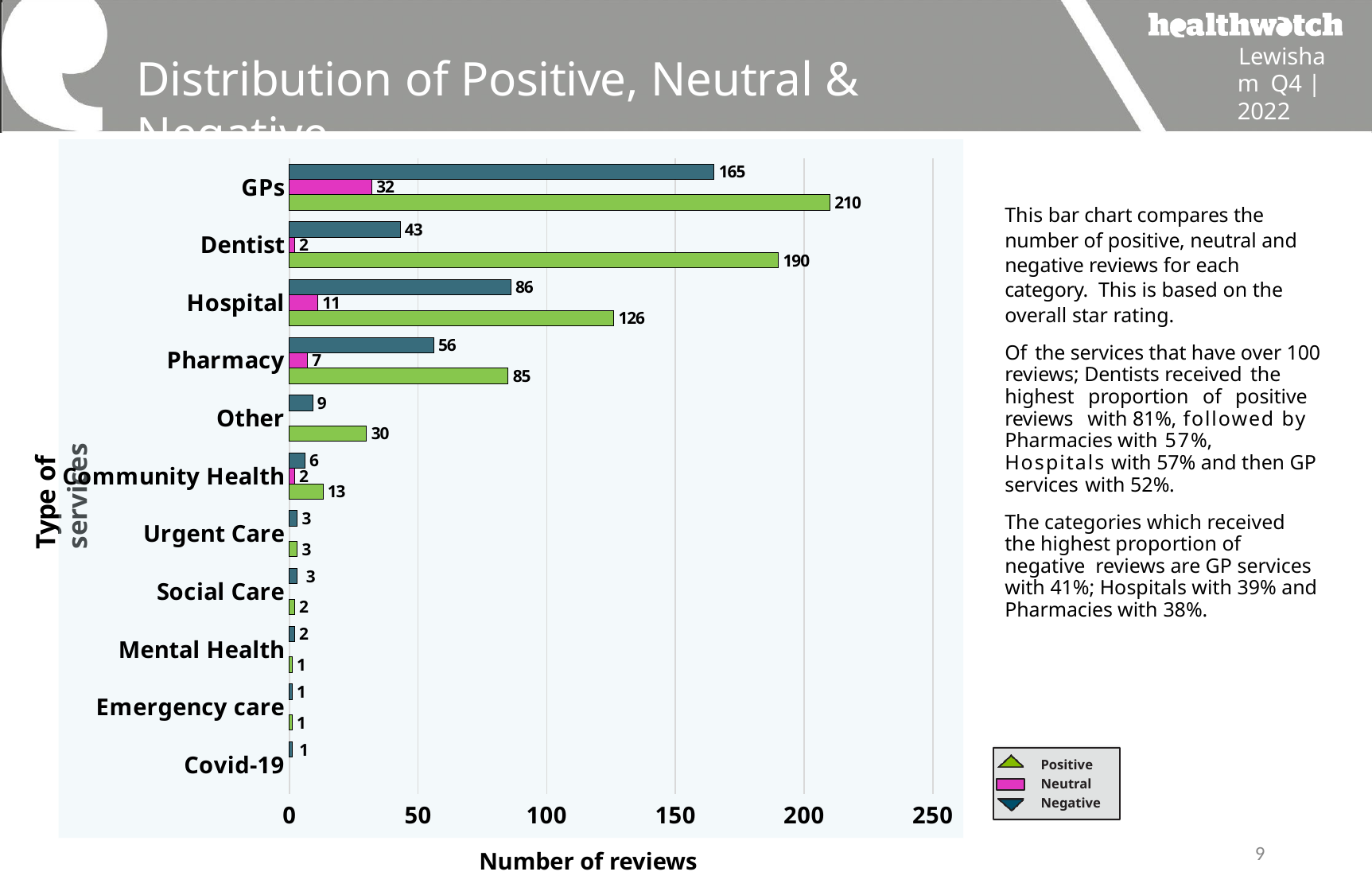
How many positive reviews did GPs receive? 210 What is the label of the x axis? Number of reviews What is the difference between the positive and negative reviews for Dentist? 147 How many types of services are shown on the chart? 11 Which is larger, the number of positive reviews for Hospital or for Pharmacy? Hospital What type of chart is shown on the slide? bar chart Which type of service has the highest number of negative reviews? GPs What is the total number of reviews (positive, neutral and negative) for Community Health? 21 Which type of service has the highest number of positive reviews? GPs How many negative reviews did Hospital receive? 86 How many neutral reviews did Pharmacy receive? 7 How many series does the chart legend list? 3